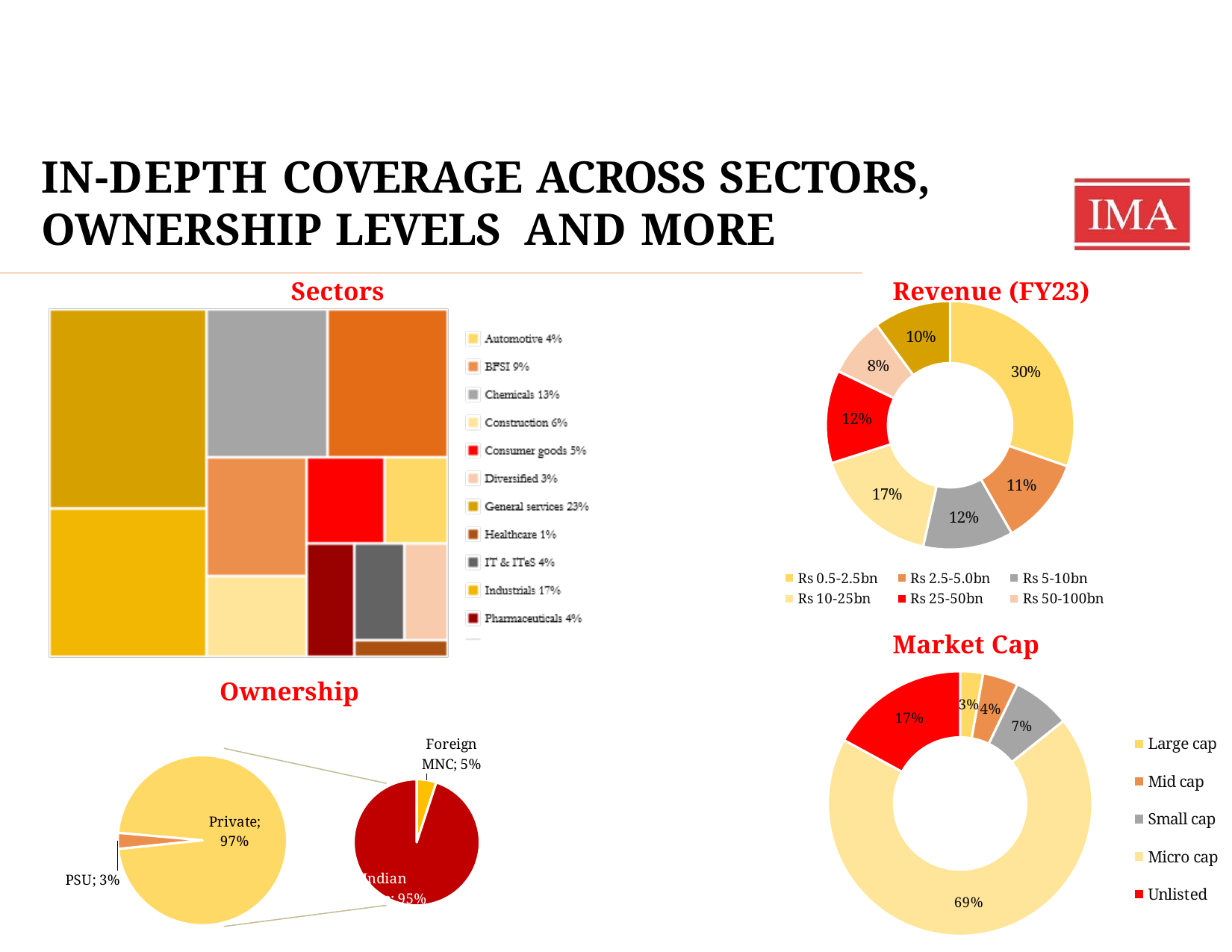
In the Market Cap chart, what is the difference between the Unlisted share and the Small cap share? 10% In the Sectors chart, what share is General services? 23% In the Market Cap chart, which category has the smallest share? Large cap In the Revenue (FY23) chart, what share is Rs 0.5-2.5bn? 30% What kind of chart is the Revenue (FY23) chart? Doughnut chart In the Revenue (FY23) chart, which is larger: Rs 2.5-5.0bn or Rs 50-100bn? Rs 2.5-5.0bn How many sectors does the legend of the Sectors chart list? 11 In the Ownership chart, what share is Private? 97% In the Market Cap chart, what share is Micro cap? 69% In the Sectors chart, which sector has the smallest share? Healthcare How many categories does the legend of the Market Cap chart list? 5 In the Revenue (FY23) chart, what share is Rs 10-25bn? 17%